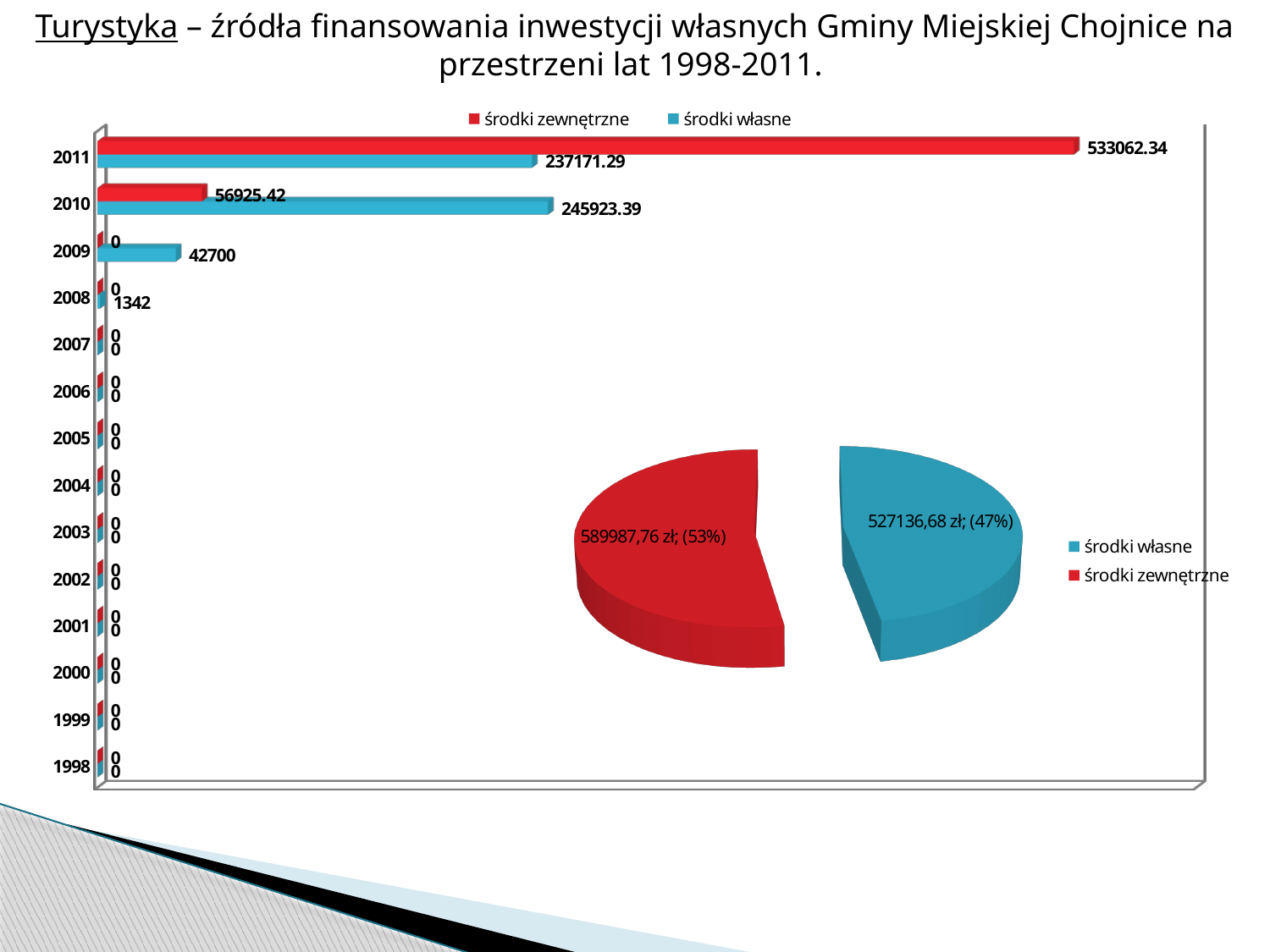
In the bar chart, what is the difference between środki zewnętrzne and środki własne in 2011? 295891.05 What type of chart is the chart on the left showing the years 1998-2011? bar chart In the pie chart, what is the value shown for środki własne? 527136,68 zł In the bar chart, what is the value of środki własne for 2009? 42700 In the bar chart, which is larger in 2010: środki zewnętrzne or środki własne? środki własne In the bar chart, which year has the highest value of środki zewnętrzne? 2011 In the pie chart, what share does środki zewnętrzne have? 53% In the bar chart, what is the value of środki zewnętrzne for 2011? 533062.34 How many series does the bar chart's legend list? 2 In the bar chart, what is the value of środki własne for 2010? 245923.39 How many years are shown on the bar chart? 14 In the bar chart, what is the value of środki własne for 2008? 1342